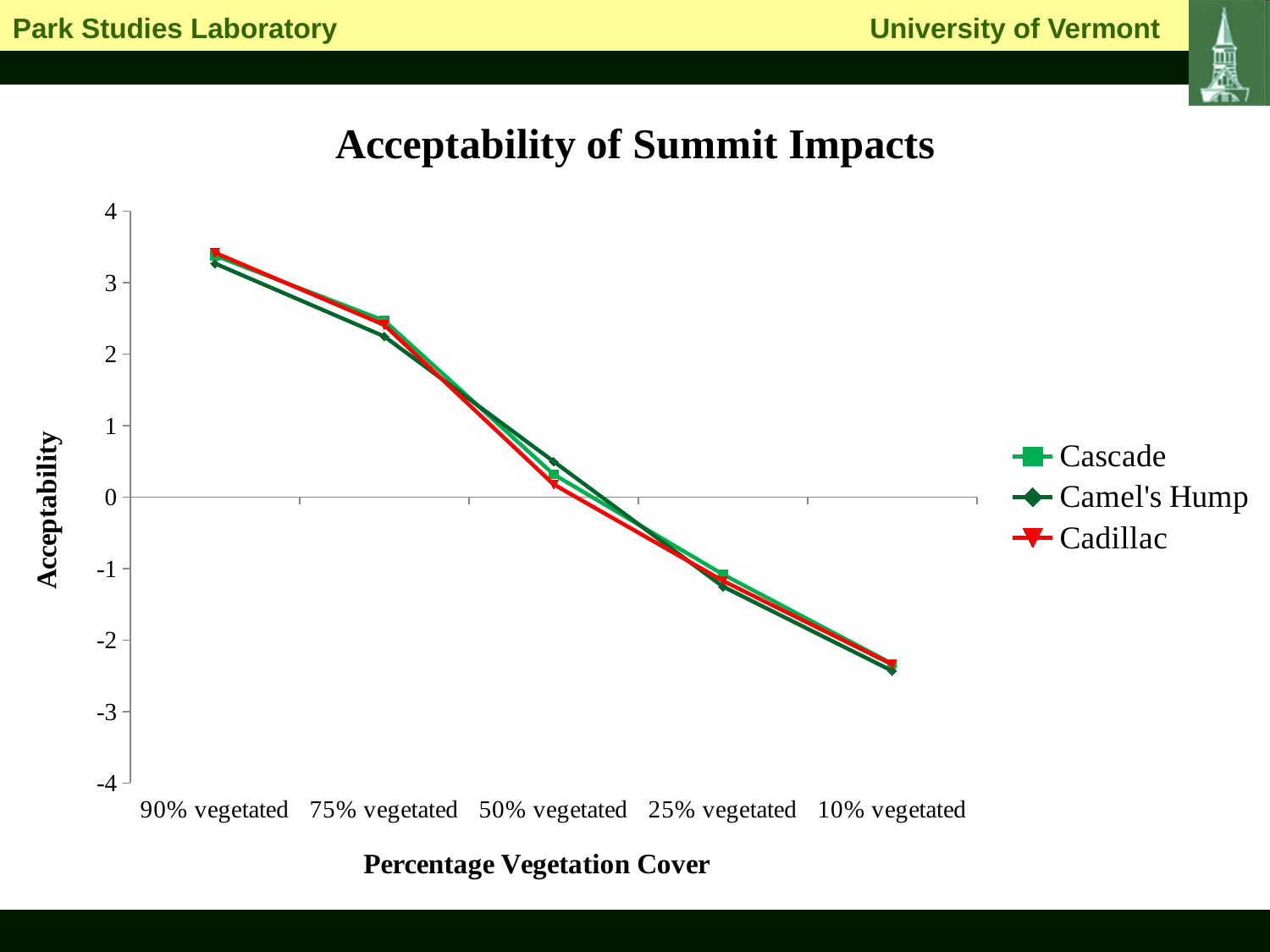
Is the Camel's Hump value for 75% vegetated greater or less than 2? greater Is the Cadillac value for 25% vegetated greater or less than -1? less How many series does the legend list? 3 At which vegetation cover category is the Cascade series highest? 90% vegetated What kind of chart is shown on the slide? line chart At which vegetation cover category is the Camel's Hump series lowest? 10% vegetated How many vegetation cover categories are shown on the x axis? 5 Is the Camel's Hump value for 10% vegetated greater or less than -2? less What is the title of the chart? Acceptability of Summit Impacts Do the acceptability values rise or fall as vegetation cover goes from 90% vegetated to 10% vegetated? fall